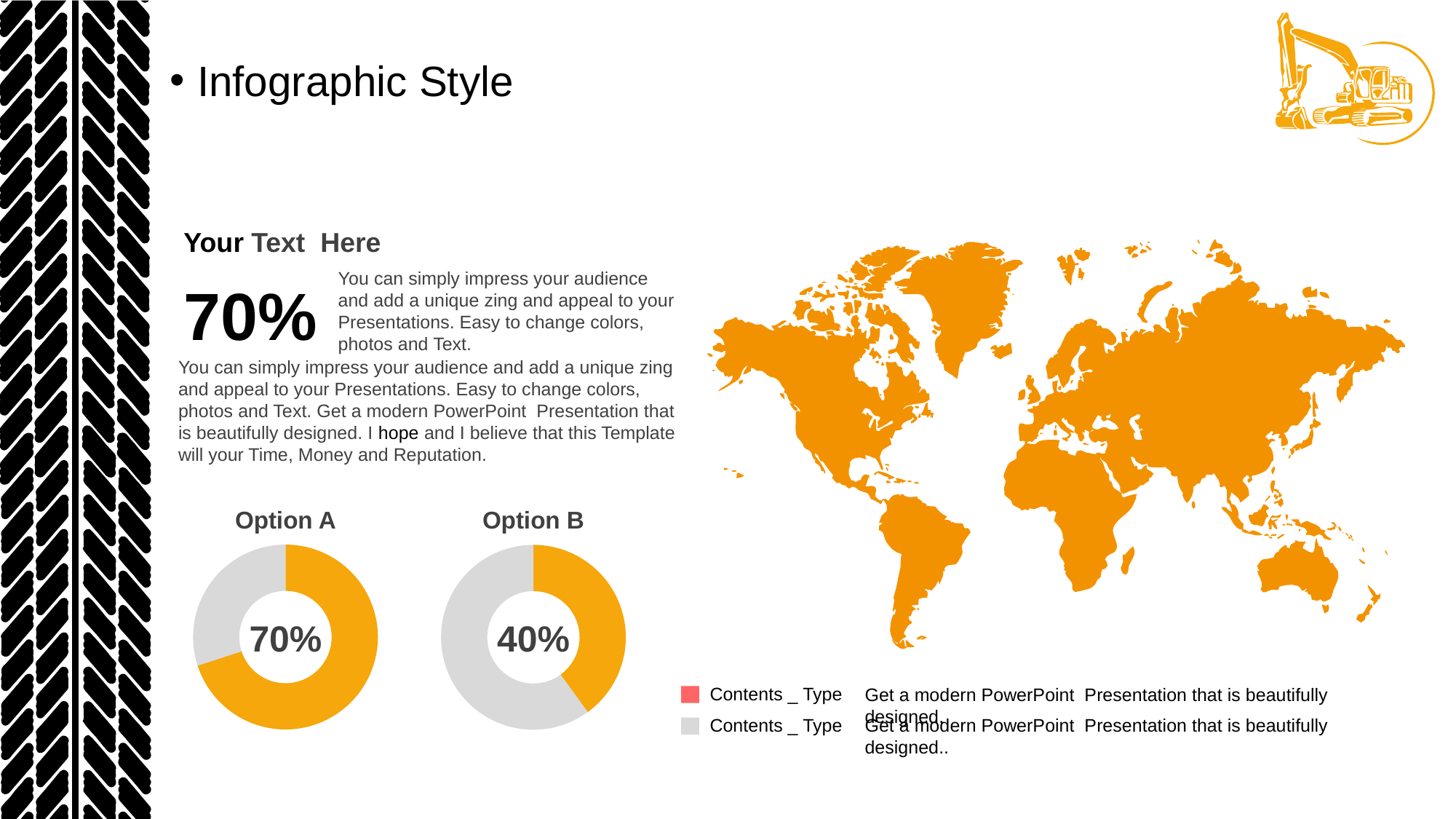
How many slices does the Option A doughnut chart have? 2 What is the difference between the percentage shown for Option A and the percentage shown for Option B? 30% Which of the two doughnut charts shows the lowest percentage? Option B How many doughnut charts are on the slide? 2 Which of the two doughnut charts shows the highest percentage? Option A In the Option A doughnut chart, what percentage is shown in the centre? 70% What kind of chart is used for Option A and Option B? doughnut chart In the Option B doughnut chart, what percentage is shown in the centre? 40% In the Option B doughnut chart, does the orange slice cover more or less than half of the ring? less In the Option A doughnut chart, what colour is the larger slice? orange Which option shows the larger percentage, Option A or Option B? Option A In the Option B doughnut chart, what colour is the larger slice? grey